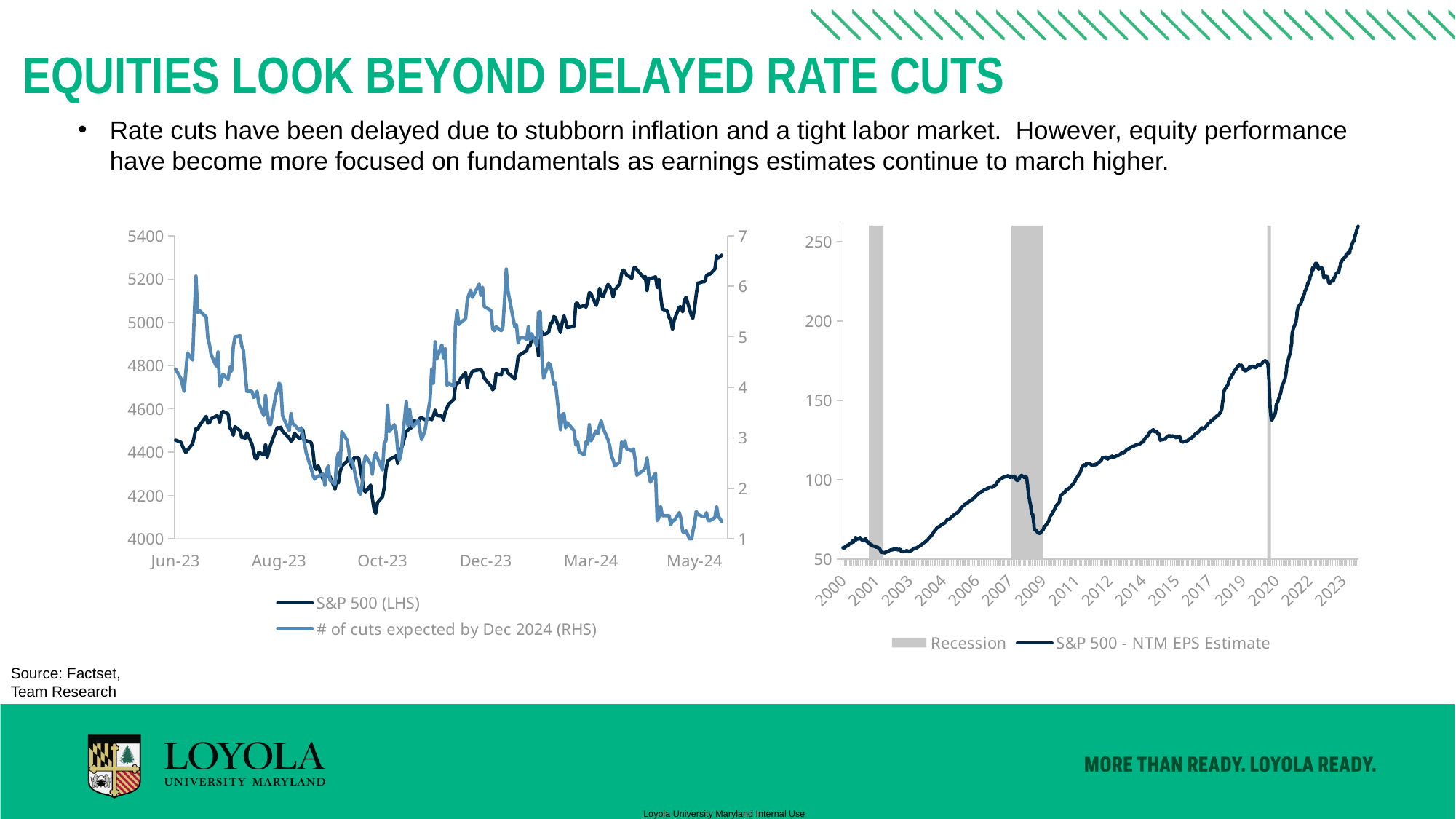
On the right chart, how many entries does the legend list? 2 On the left chart, is the number of cuts expected by Dec 2024 at May-24 greater or less than 2? less What kind of chart is the right chart? Line chart On the right chart, does the S&P 500 NTM EPS Estimate rise or fall overall from 2000 to 2023? Rise On the right chart, is the S&P 500 NTM EPS Estimate in 2000 greater or less than 100? less On the left chart, how many series does the legend list? 2 On the left chart, is the S&P 500 value at May-24 greater or less than 5000? greater What kind of chart is the left chart? Line chart On the left chart, does the S&P 500 (LHS) series rise or fall overall from Jun-23 to May-24? Rise On the left chart, does the '# of cuts expected by Dec 2024 (RHS)' series rise or fall overall from Jun-23 to May-24? Fall